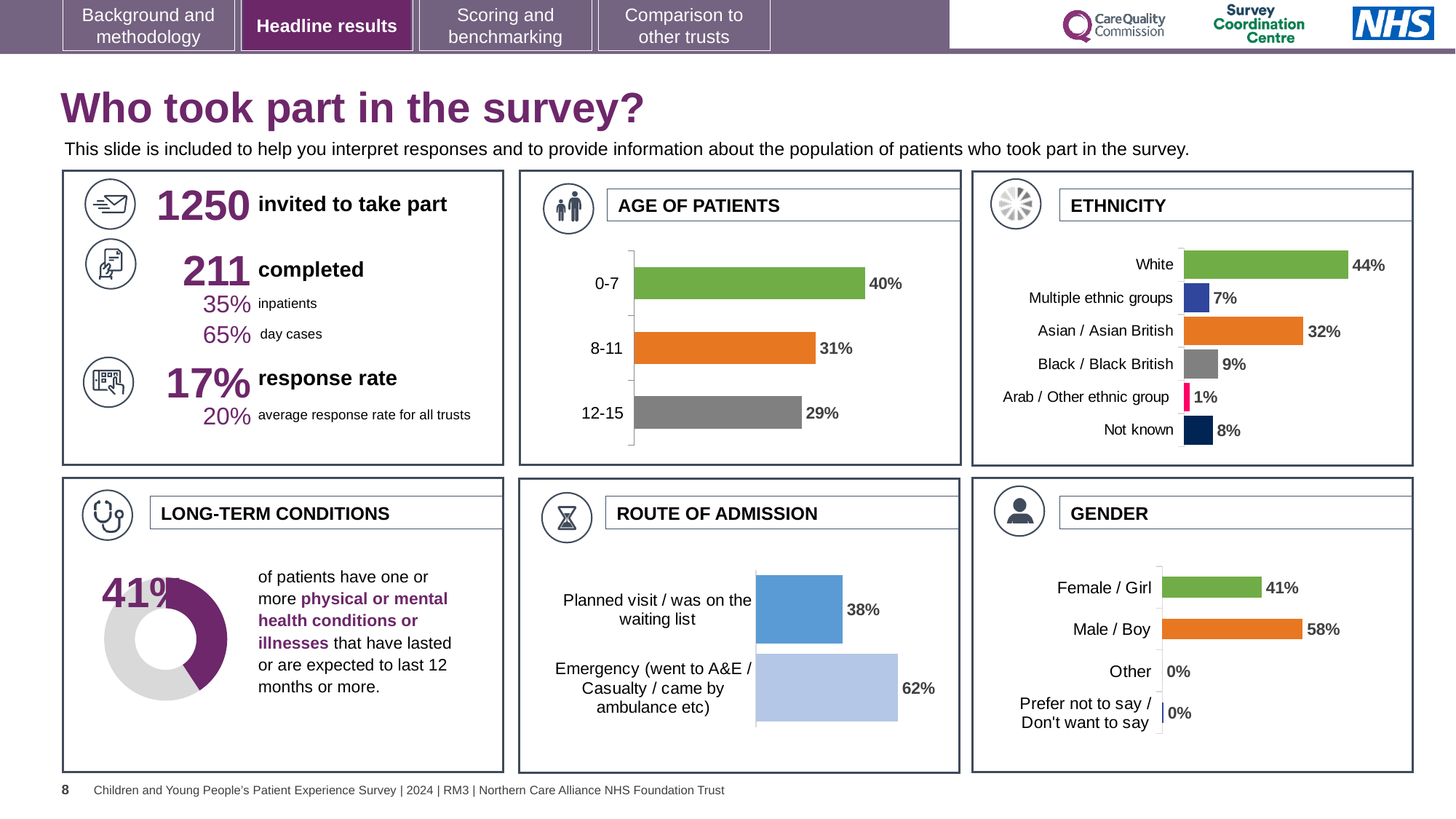
In the GENDER chart, what is the value for Male / Boy? 58% What kind of chart is used in the LONG-TERM CONDITIONS panel? Doughnut chart In the AGE OF PATIENTS chart, what is the value for the 8-11 age group? 31% In the AGE OF PATIENTS chart, what is the difference between the 0-7 and 12-15 values? 11% In the ROUTE OF ADMISSION chart, what is the difference between the Emergency and Planned visit values? 24% In the ETHNICITY chart, which category has the lowest value? Arab / Other ethnic group In the AGE OF PATIENTS chart, which age group has the highest value? 0-7 In the ETHNICITY chart, what is the value for Asian / Asian British? 32% In the ETHNICITY chart, which is larger: Black / Black British or Not known? Black / Black British In the GENDER chart, which category has the highest value? Male / Boy In the ROUTE OF ADMISSION chart, what is the value for Emergency (went to A&E / Casualty / came by ambulance etc)? 62% In the ETHNICITY chart, how many categories are shown? 6